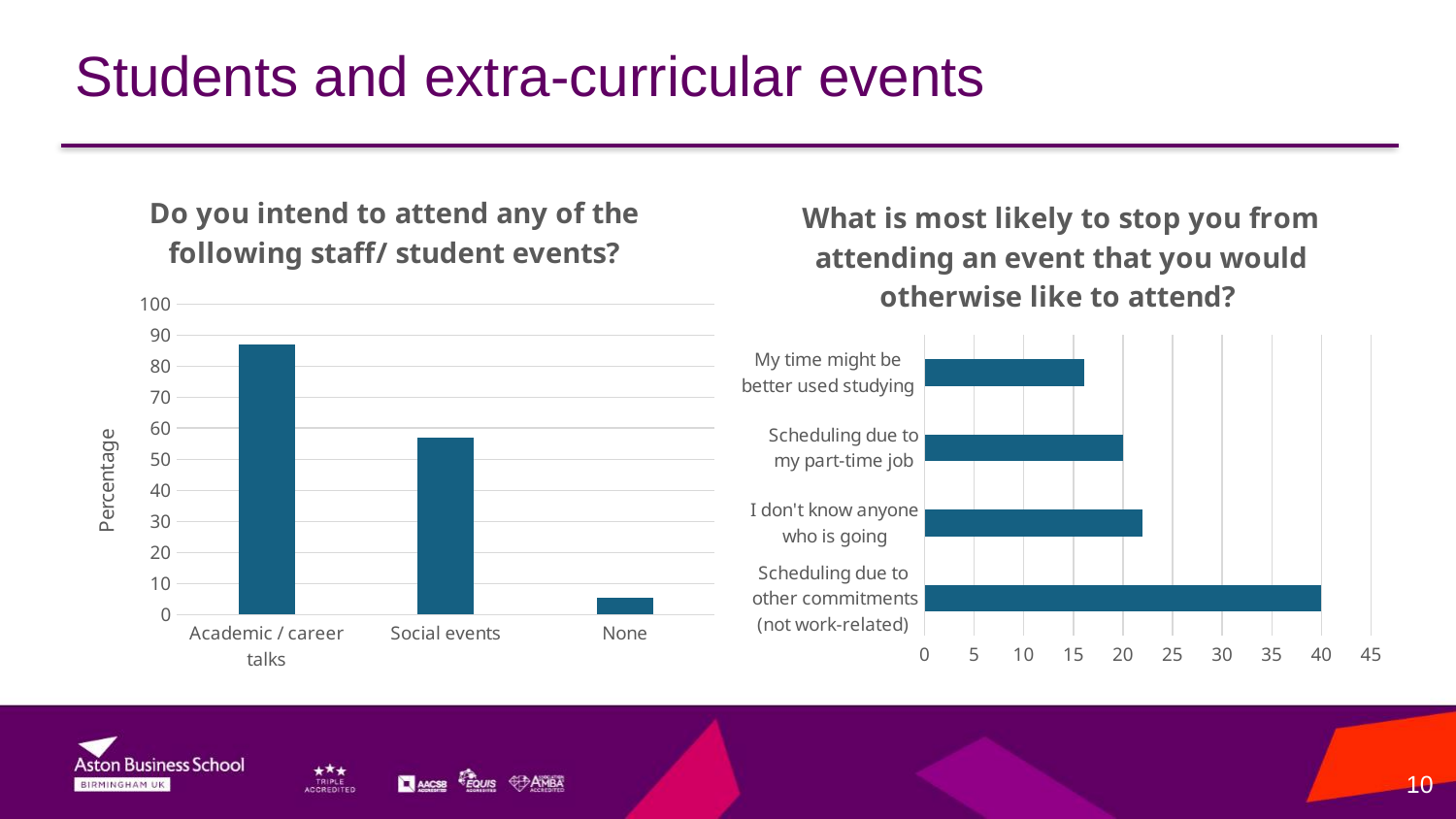
In the left chart 'Do you intend to attend any of the following staff/ student events?', which category has the highest percentage? Academic / career talks In the left chart 'Do you intend to attend any of the following staff/ student events?', which category has the lowest percentage? None In the right chart 'What is most likely to stop you from attending an event that you would otherwise like to attend?', is the value for 'My time might be better used studying' greater or less than 20? less In the right chart 'What is most likely to stop you from attending an event that you would otherwise like to attend?', which reason has the lowest value? My time might be better used studying In the left chart 'Do you intend to attend any of the following staff/ student events?', how many categories are shown? 3 In the right chart 'What is most likely to stop you from attending an event that you would otherwise like to attend?', how many reasons are listed? 4 In the left chart 'Do you intend to attend any of the following staff/ student events?', what is the label of the vertical axis? Percentage In the right chart 'What is most likely to stop you from attending an event that you would otherwise like to attend?', which reason has the highest value? Scheduling due to other commitments (not work-related) In the right chart 'What is most likely to stop you from attending an event that you would otherwise like to attend?', what is the value for 'Scheduling due to other commitments (not work-related)'? 40 In the left chart 'Do you intend to attend any of the following staff/ student events?', is the value for Academic / career talks greater or less than 80? greater What type of chart is the left chart titled 'Do you intend to attend any of the following staff/ student events?'? bar chart In the left chart 'Do you intend to attend any of the following staff/ student events?', is the value for Social events greater or less than 60? less